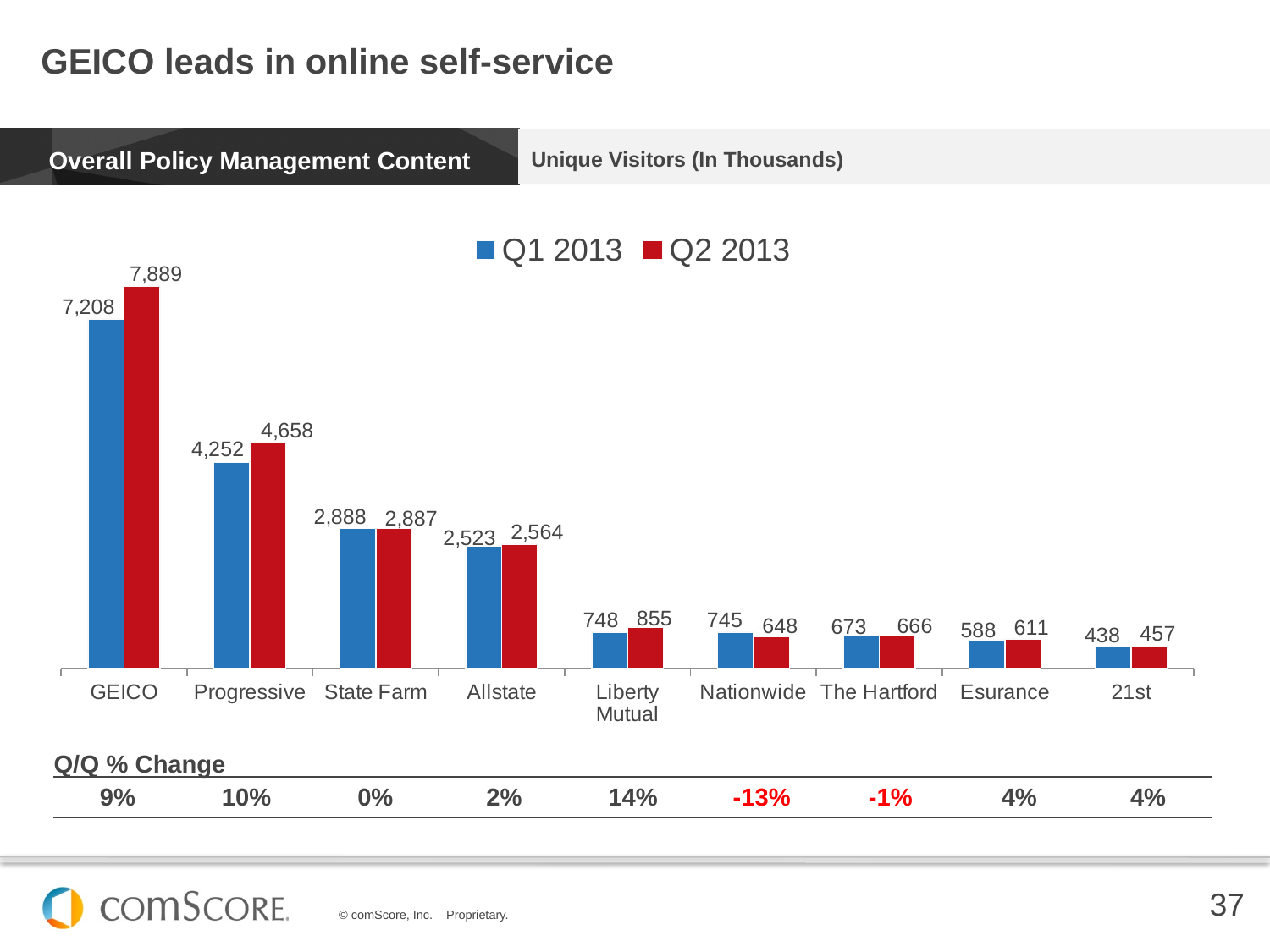
What is the Q2 2013 value for Esurance? 611 Which is larger for Nationwide, the Q1 2013 value or the Q2 2013 value? Q1 2013 What is the Q/Q % change shown for Liberty Mutual? 14% What is the Q1 2013 value for Nationwide? 745 Which company has the highest Q1 2013 value? GEICO What colour represents the Q2 2013 series in the legend? Red Which company has the lowest Q2 2013 value? 21st What kind of chart is shown on the slide? Bar chart How many series does the legend list? 2 What is the difference between the Q2 2013 and Q1 2013 values for Progressive? 406 How many companies are shown on the x axis? 9 What is the Q2 2013 value for GEICO? 7,889